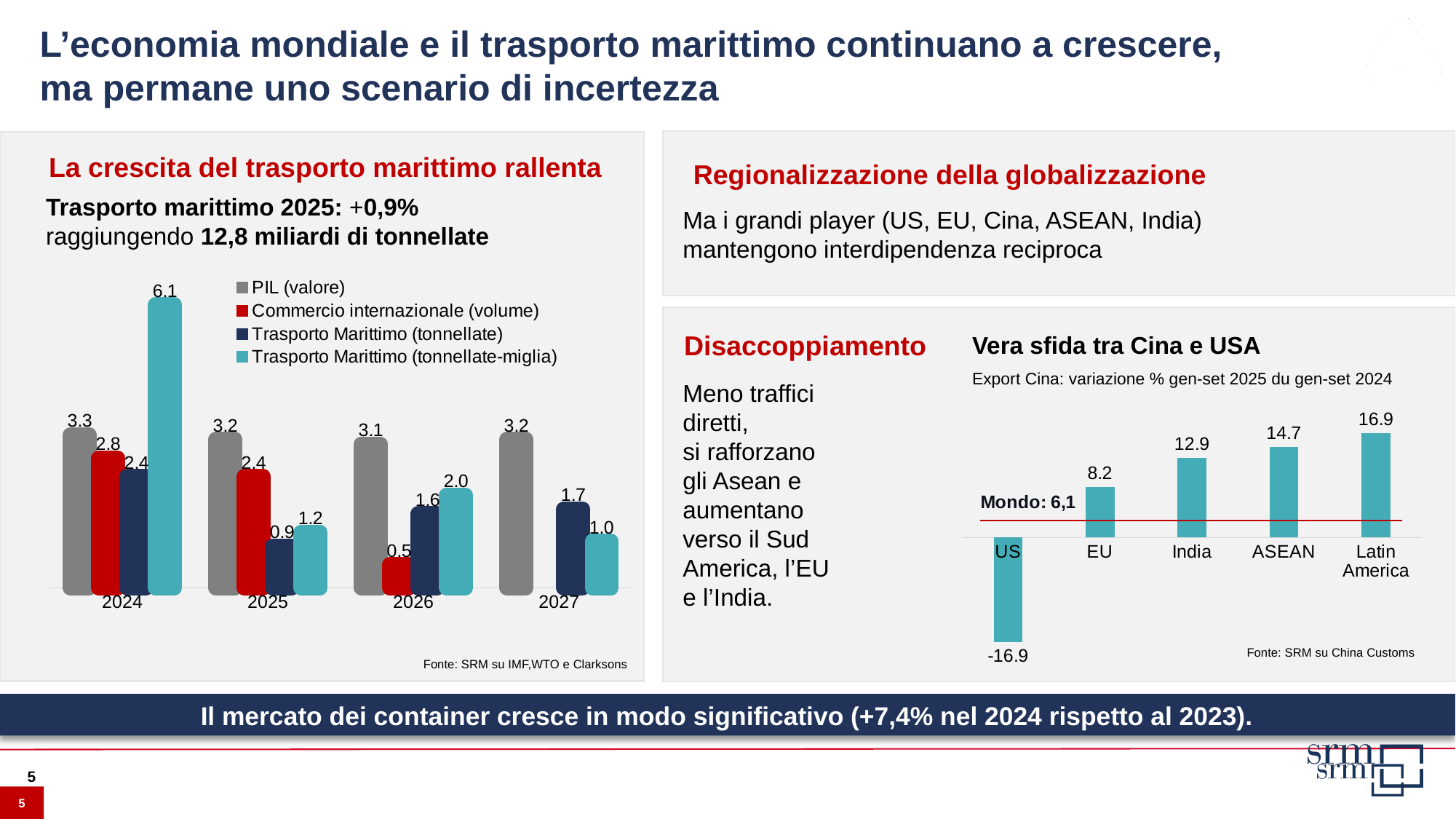
In the right chart (Export Cina), what is the difference between the values for ASEAN and EU? 6.5 In the left chart, does the Trasporto Marittimo (tonnellate-miglia) series rise or fall from 2024 to 2025? fall In the left chart, which is larger in 2025: Trasporto Marittimo (tonnellate) or Trasporto Marittimo (tonnellate-miglia)? Trasporto Marittimo (tonnellate-miglia) In the left chart, what is the difference between PIL (valore) in 2024 and in 2026? 0.2 In the right chart (Export Cina), what is the value for India? 12.9 What kind of chart is the Export Cina chart on the right? bar chart In the left chart, how many series does the legend list? 4 In the left chart, how many years are shown on the x axis? 4 In the left chart, what is the value of Commercio internazionale (volume) for 2026? 0.5 In the right chart (Export Cina), which category has the lowest value? US In the right chart (Export Cina: variazione % gen-set 2025 su gen-set 2024), which category has the highest value? Latin America In the left chart (La crescita del trasporto marittimo rallenta), what is the value of Trasporto Marittimo (tonnellate-miglia) for 2024? 6.1